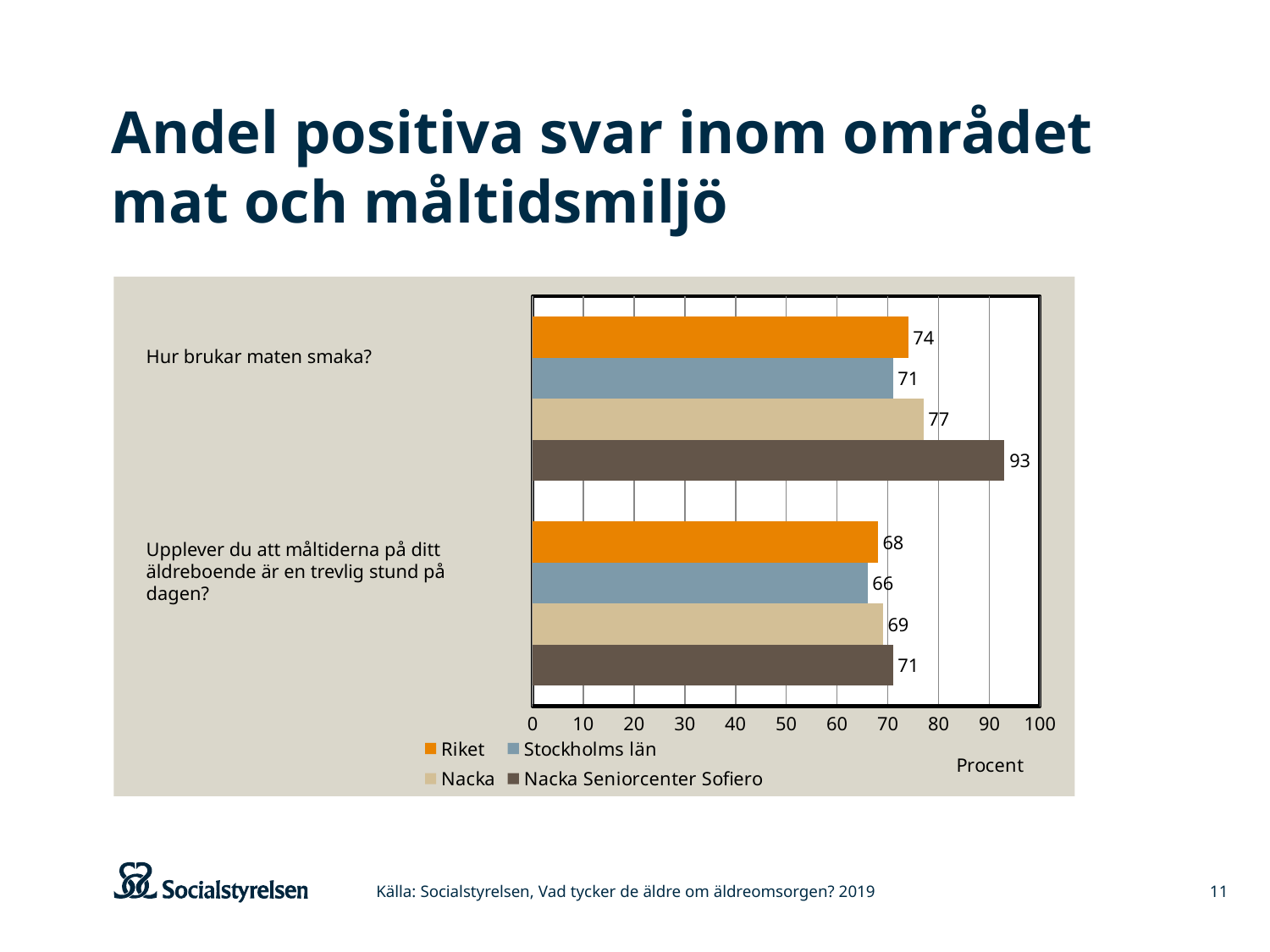
What unit is labelled on the horizontal axis of the chart? Procent What is the difference between the Nacka Seniorcenter Sofiero value and the Riket value for "Hur brukar maten smaka?"? 19 What is the value for Stockholms län for "Hur brukar maten smaka?"? 71 Which series has the highest value for "Hur brukar maten smaka?"? Nacka Seniorcenter Sofiero How many series does the legend list? 4 What kind of chart is shown on the slide? Bar chart What is the value for Riket for "Upplever du att måltiderna på ditt äldreboende är en trevlig stund på dagen?"? 68 Which is larger for "Upplever du att måltiderna på ditt äldreboende är en trevlig stund på dagen?": Riket or Nacka Seniorcenter Sofiero? Nacka Seniorcenter Sofiero What is the value for Nacka for "Upplever du att måltiderna på ditt äldreboende är en trevlig stund på dagen?"? 69 What is the value for Nacka Seniorcenter Sofiero for "Hur brukar maten smaka?"? 93 Which series has the lowest value for "Upplever du att måltiderna på ditt äldreboende är en trevlig stund på dagen?"? Stockholms län How many question categories are shown on the chart? 2